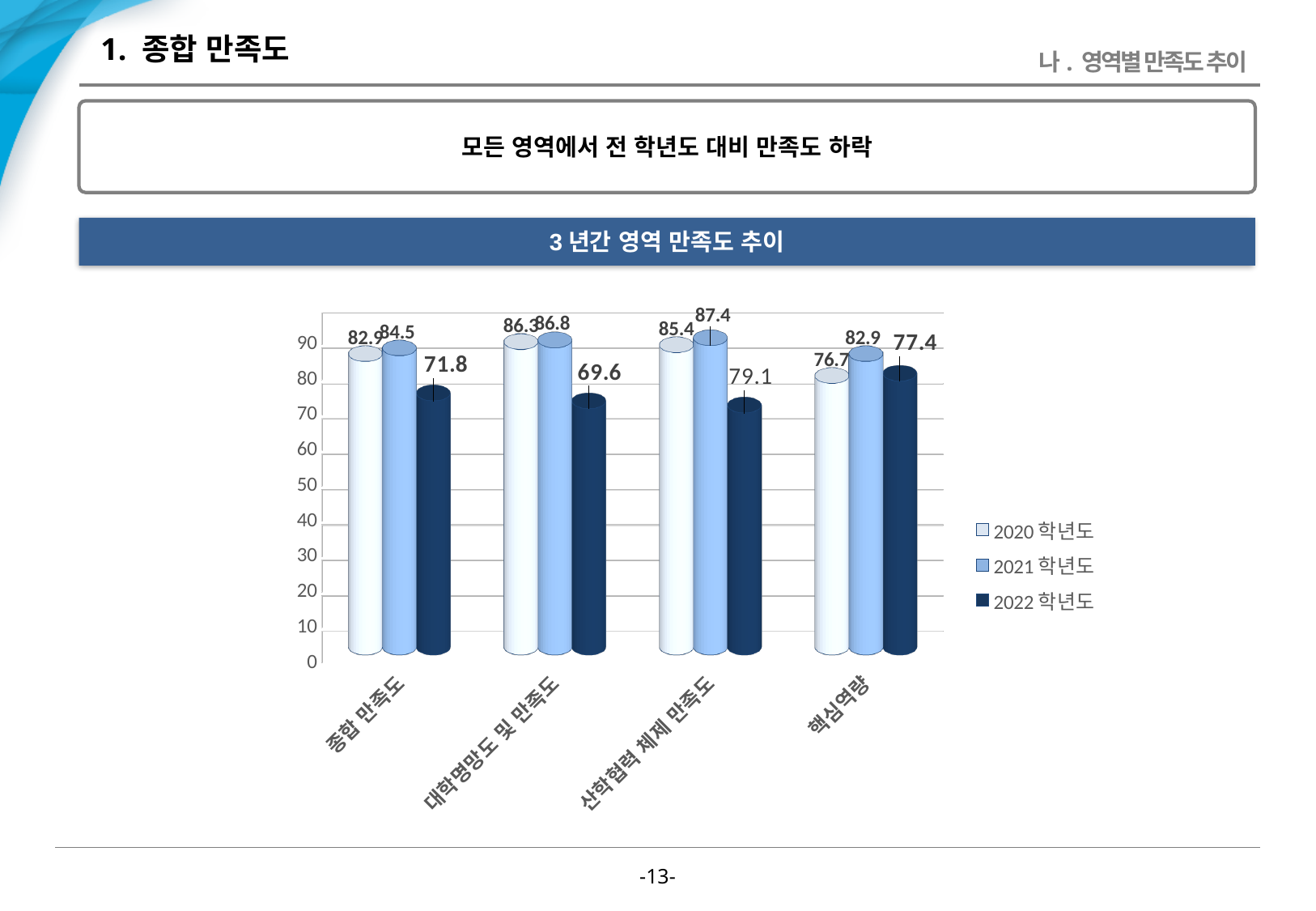
Which is larger in the 2022 학년도 series: 핵심역량 or 종합 만족도? 핵심역량 What is the value for 핵심역량 in the 2020 학년도 series? 76.7 Is the value for 종합 만족도 in the 2020 학년도 series greater or less than 80? greater What is the value for 대학명망도 및 만족도 in the 2022 학년도 series? 69.6 What is the value for 산학협력 체제 만족도 in the 2021 학년도 series? 87.4 Which category has the highest value in the 2021 학년도 series? 산학협력 체제 만족도 How many series does the legend list? 3 What kind of chart is shown on the slide? bar chart For 산학협력 체제 만족도, what is the difference between the 2021 학년도 and 2022 학년도 values? 8.3 How many categories are shown on the x axis? 4 What is the value for 종합 만족도 in the 2022 학년도 series? 71.8